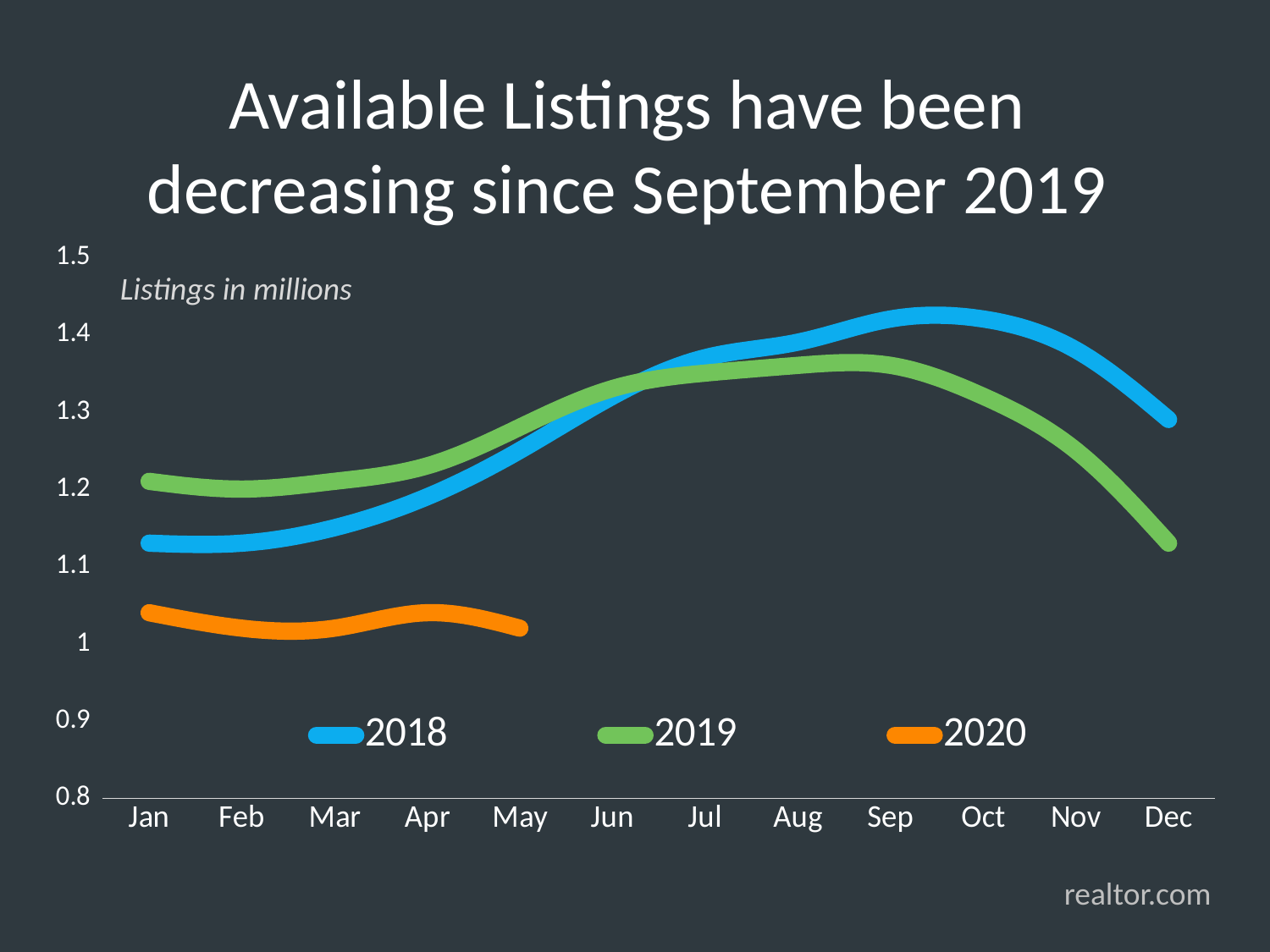
Is the value for 2020 in May greater or less than 1.1? less Through which month does the 2020 line extend? May How many series does the legend list? 3 Is the value for 2018 in January greater or less than 1.2? less Which series has the lowest value in January? 2020 How many months are shown on the x axis? 12 Is the value for 2018 in October greater or less than 1.4? greater Does the 2019 line rise or fall from September to December? fall Which series has the highest value in January? 2019 What kind of chart is shown on the slide? line chart Which is larger in December, the 2018 value or the 2019 value? 2018